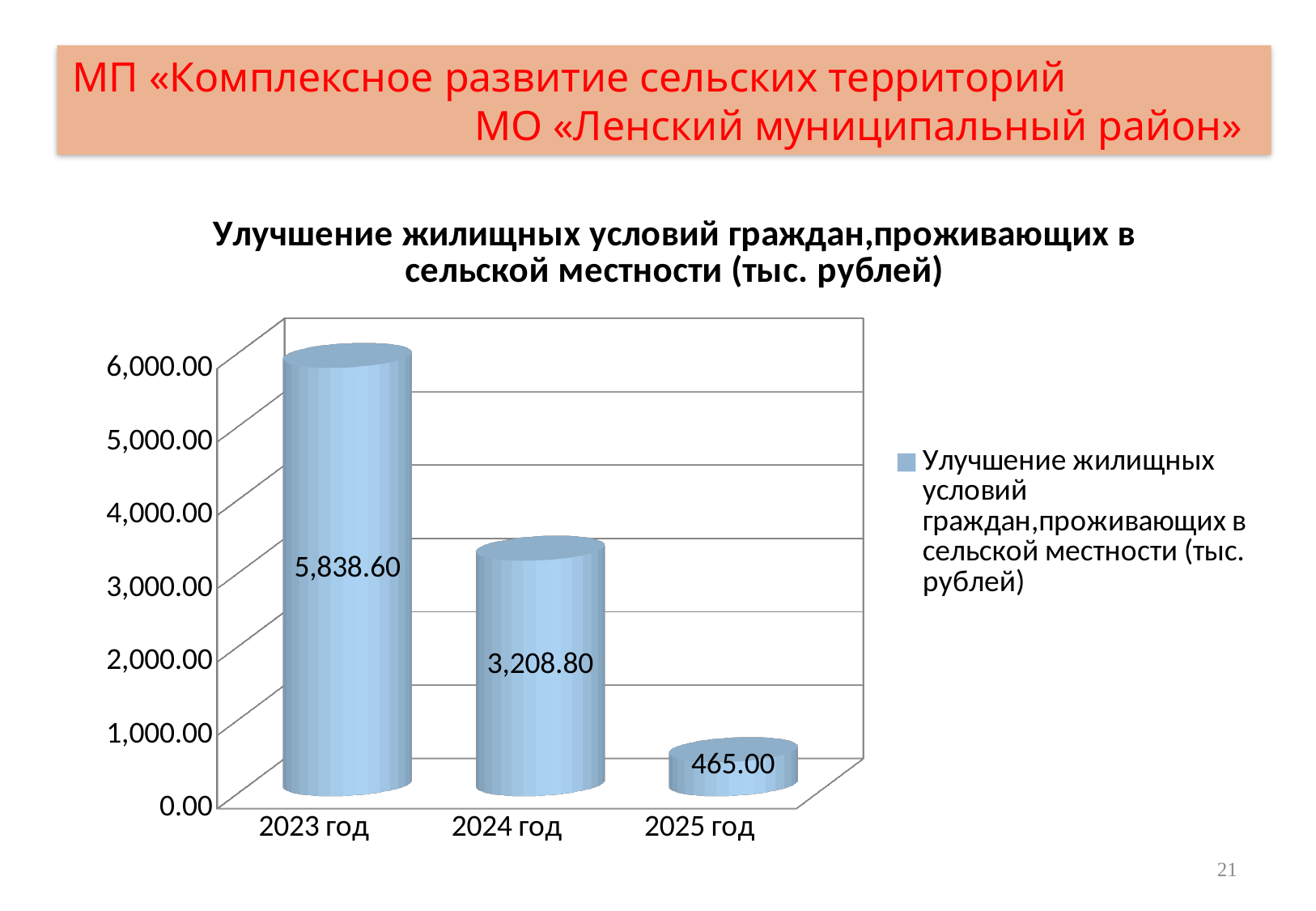
What is the difference between the values for 2024 год and 2025 год? 2,743.80 Which year has the lowest value? 2025 год What is the value for 2023 год? 5,838.60 Which is larger, the value for 2024 год or the value for 2025 год? 2024 год Is the value for 2024 год greater or less than 3,000.00? greater Which year has the highest value? 2023 год What is the value for 2025 год? 465.00 What kind of chart is shown on the slide? bar chart What is the difference between the values for 2023 год and 2024 год? 2,629.80 How many years are shown on the x axis? 3 What is the value for 2024 год? 3,208.80 Do the values rise or fall from 2023 год to 2025 год? fall